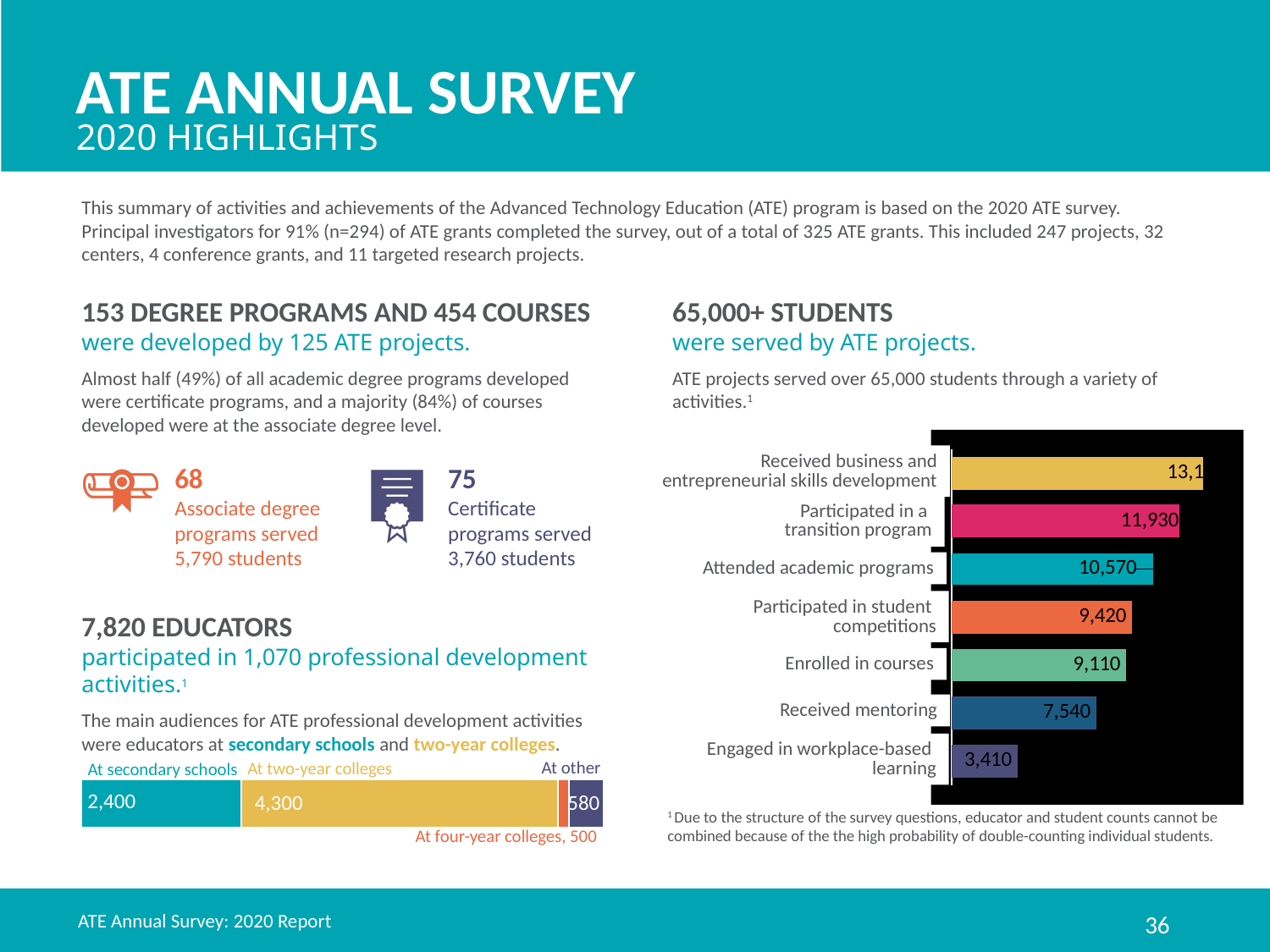
In the students chart on the right, which activity has the highest number of students? Received business and entrepreneurial skills development In the educators stacked bar at the bottom left, which audience segment is the largest? At two-year colleges In the students chart on the right, what is the difference between the number who participated in a transition program and the number who attended academic programs? 1,360 In the students chart on the right, how many students participated in a transition program? 11,930 What kind of chart is the students chart on the right? Bar chart How many activity categories are shown in the students chart on the right? 7 In the educators stacked bar at the bottom left, how many educators were at two-year colleges? 4,300 In the students chart on the right, how many students attended academic programs? 10,570 In the students chart on the right, how many students received mentoring? 7,540 In the students chart on the right, which activity has the lowest number of students? Engaged in workplace-based learning In the students chart on the right, what is the difference between the number who received mentoring and the number engaged in workplace-based learning? 4,130 In the students chart on the right, which is larger: the number enrolled in courses or the number who received mentoring? Enrolled in courses